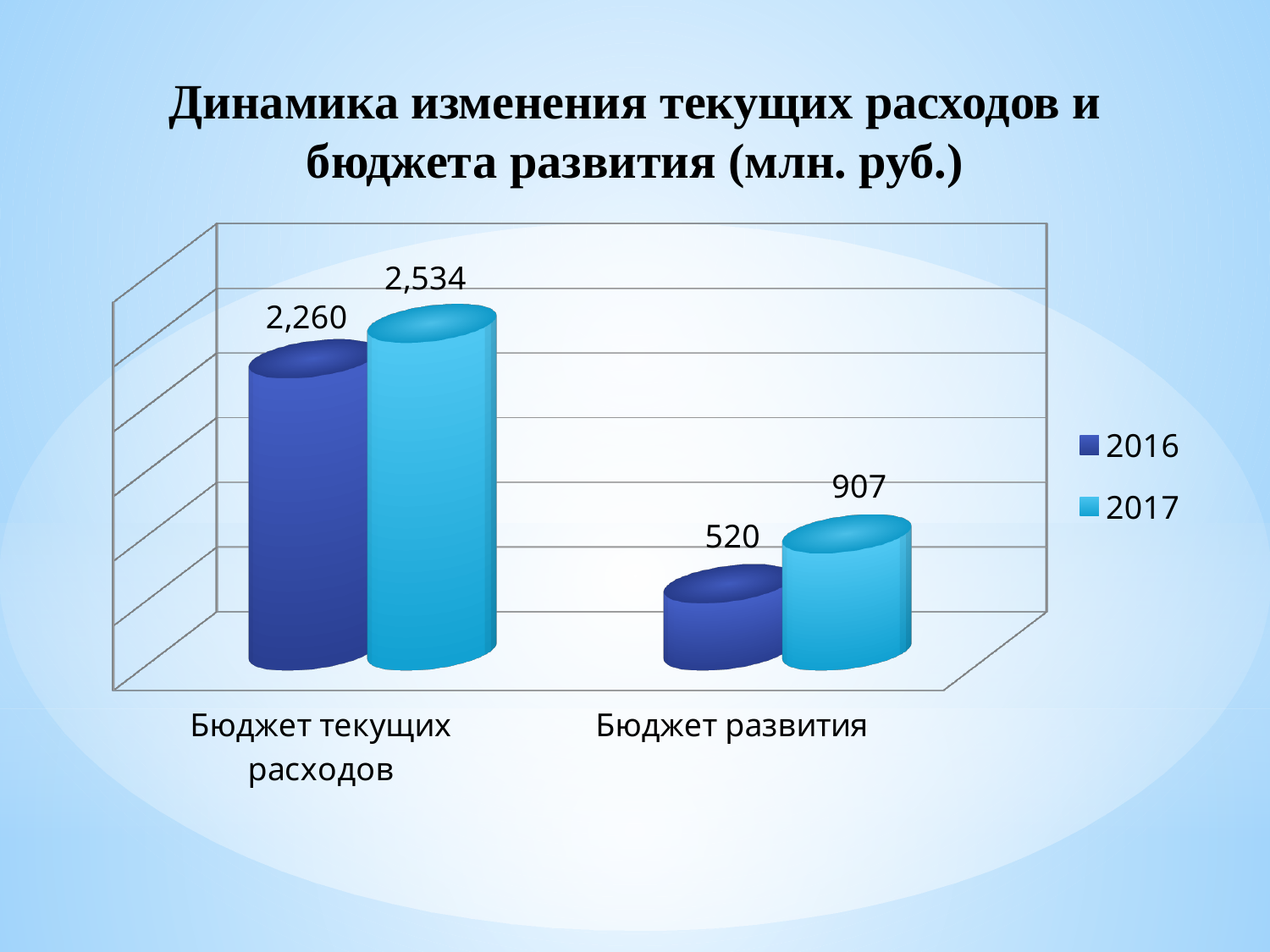
How many series does the legend list? 2 What is the difference between the 2017 and 2016 values for 'Бюджет текущих расходов'? 274 How many categories are shown on the x axis? 2 Which category has the lowest value for 2016? Бюджет развития What is the value for 2016 in the 'Бюджет текущих расходов' category? 2,260 Which is larger for 'Бюджет развития': the 2016 value or the 2017 value? 2017 What kind of chart is shown on the slide? Bar chart What is the value for 2016 in the 'Бюджет развития' category? 520 What is the value for 2017 in the 'Бюджет текущих расходов' category? 2,534 What is the difference between the 2017 and 2016 values for 'Бюджет развития'? 387 Which category has the highest value for 2017? Бюджет текущих расходов What is the value for 2017 in the 'Бюджет развития' category? 907